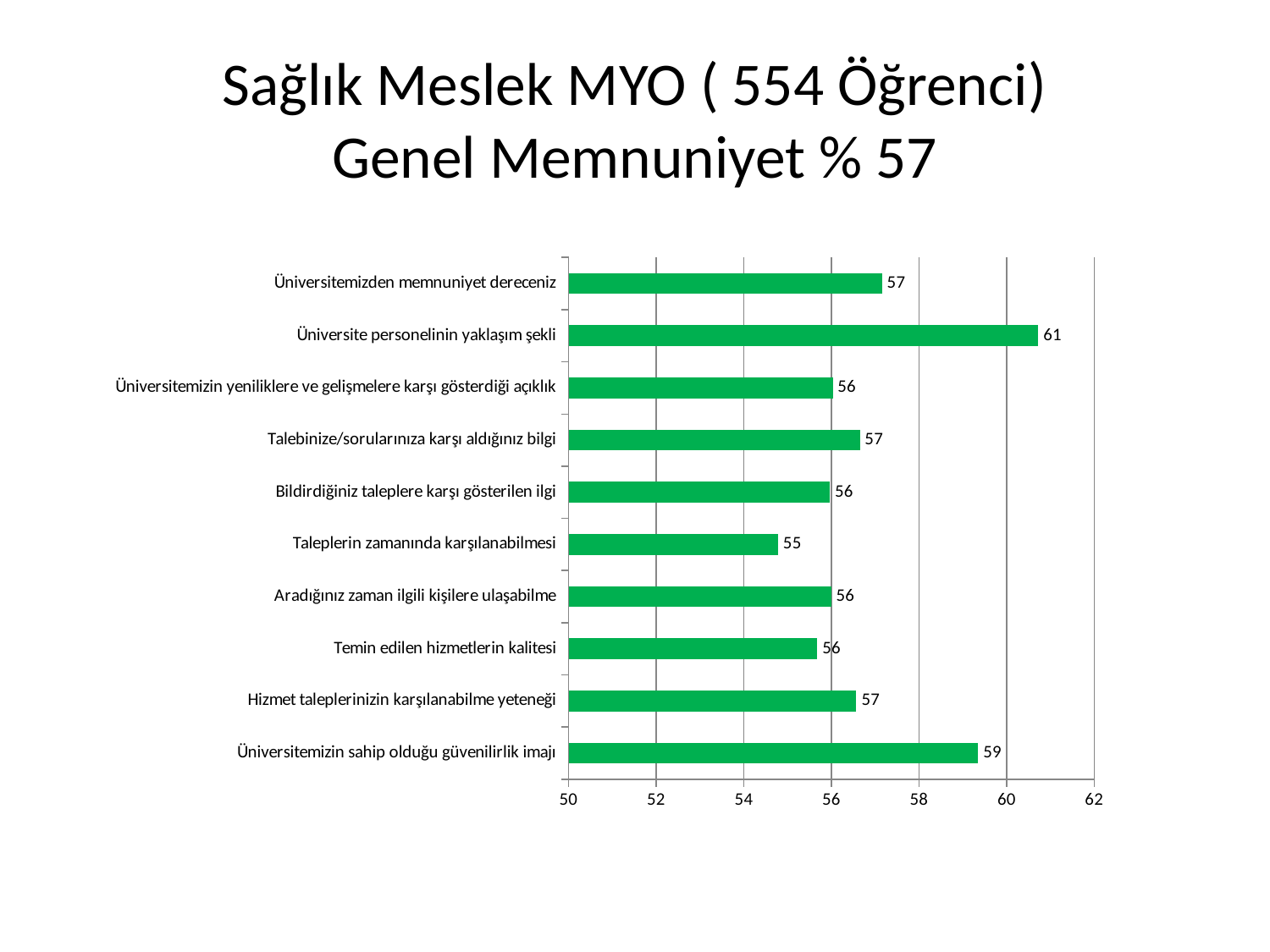
Is the value for "Üniversitemizin sahip olduğu güvenilirlik imajı" greater or less than 58? greater What is the value for "Üniversite personelinin yaklaşım şekli"? 61 What is the difference between the values for "Üniversite personelinin yaklaşım şekli" and "Taleplerin zamanında karşılanabilmesi"? 6 What is the value for "Taleplerin zamanında karşılanabilmesi"? 55 What is the value for "Üniversitemizin sahip olduğu güvenilirlik imajı"? 59 Which category has the highest value? Üniversite personelinin yaklaşım şekli Which is larger: the value for "Üniversite personelinin yaklaşım şekli" or the value for "Üniversitemizin sahip olduğu güvenilirlik imajı"? Üniversite personelinin yaklaşım şekli What is the value for "Üniversitemizden memnuniyet dereceniz"? 57 What is the title of the slide containing the chart? Sağlık Meslek MYO ( 554 Öğrenci) Genel Memnuniyet % 57 Which category has the lowest value? Taleplerin zamanında karşılanabilmesi What kind of chart is shown on the slide? bar chart How many categories are plotted in the chart? 10